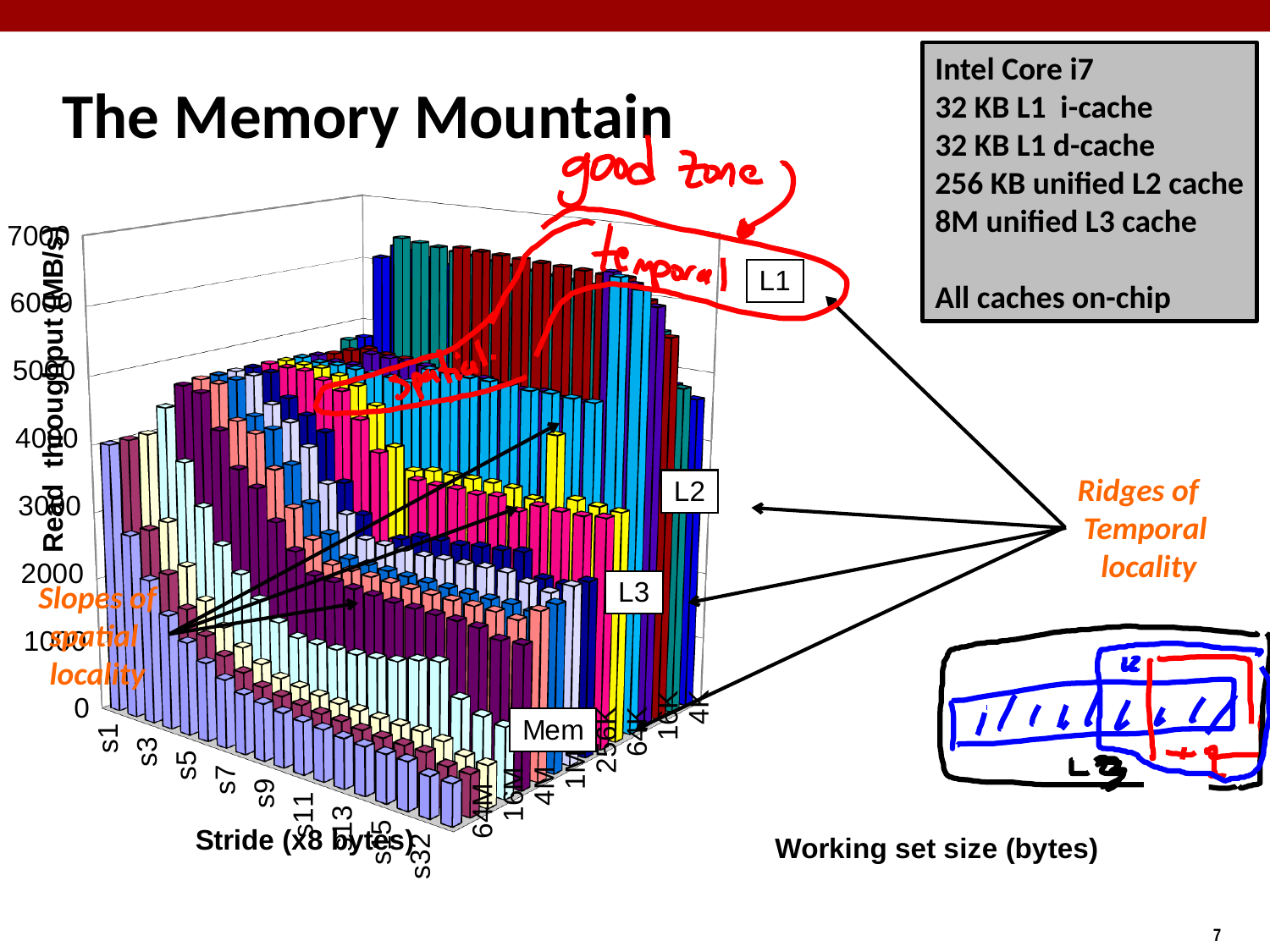
What kind of chart is shown on the slide? bar chart As the working set size decreases from 64M toward 4K at stride s1, does read throughput generally rise or fall? rise As the stride increases from s1 to s32 for a given working set size, does read throughput generally rise or fall? fall Is the read throughput for stride s1 at the 4K working set size (the L1 region) greater or less than 4000? greater What is the title of the chart on the slide? The Memory Mountain Which region of the chart, L1 or Mem, has the higher read throughput? L1 What quantity is plotted on the vertical axis of the chart? Read throughput (MB/s)